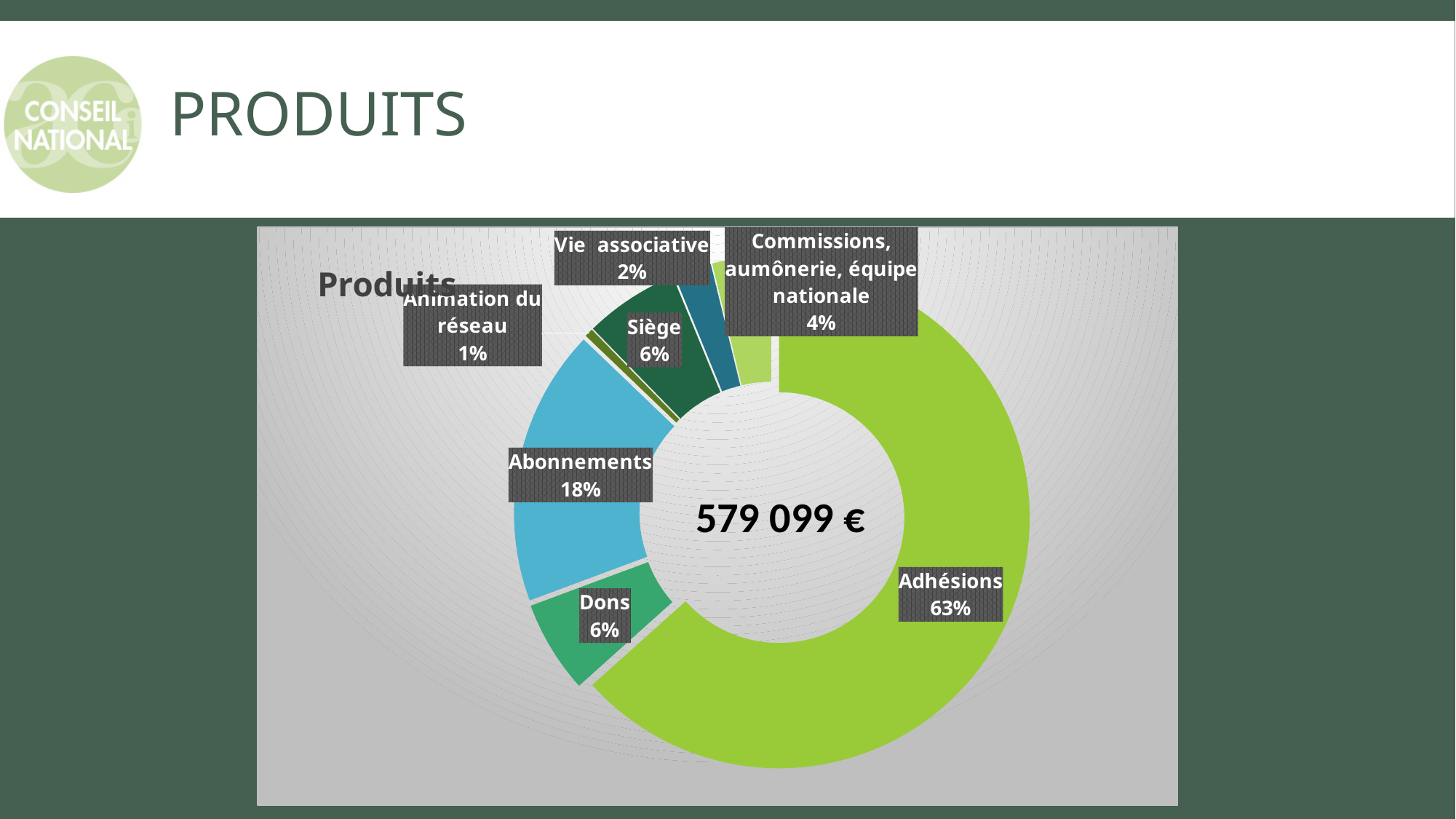
Which category has the smallest share of the chart? Animation du réseau What percentage is shown for Abonnements? 18% Which has a larger share, Siège or Vie associative? Siège What percentage is shown for Dons? 6% How many categories are shown in the chart? 7 What share of the chart does Adhésions represent? 63% What total amount is displayed in the centre of the chart? 579 099 € What percentage is shown for Animation du réseau? 1% What is the difference in percentage points between Adhésions and Abonnements? 45 What percentage is shown for Commissions, aumônerie, équipe nationale? 4% What kind of chart is shown on the slide? Doughnut (pie) chart Which category has the largest share of the chart? Adhésions